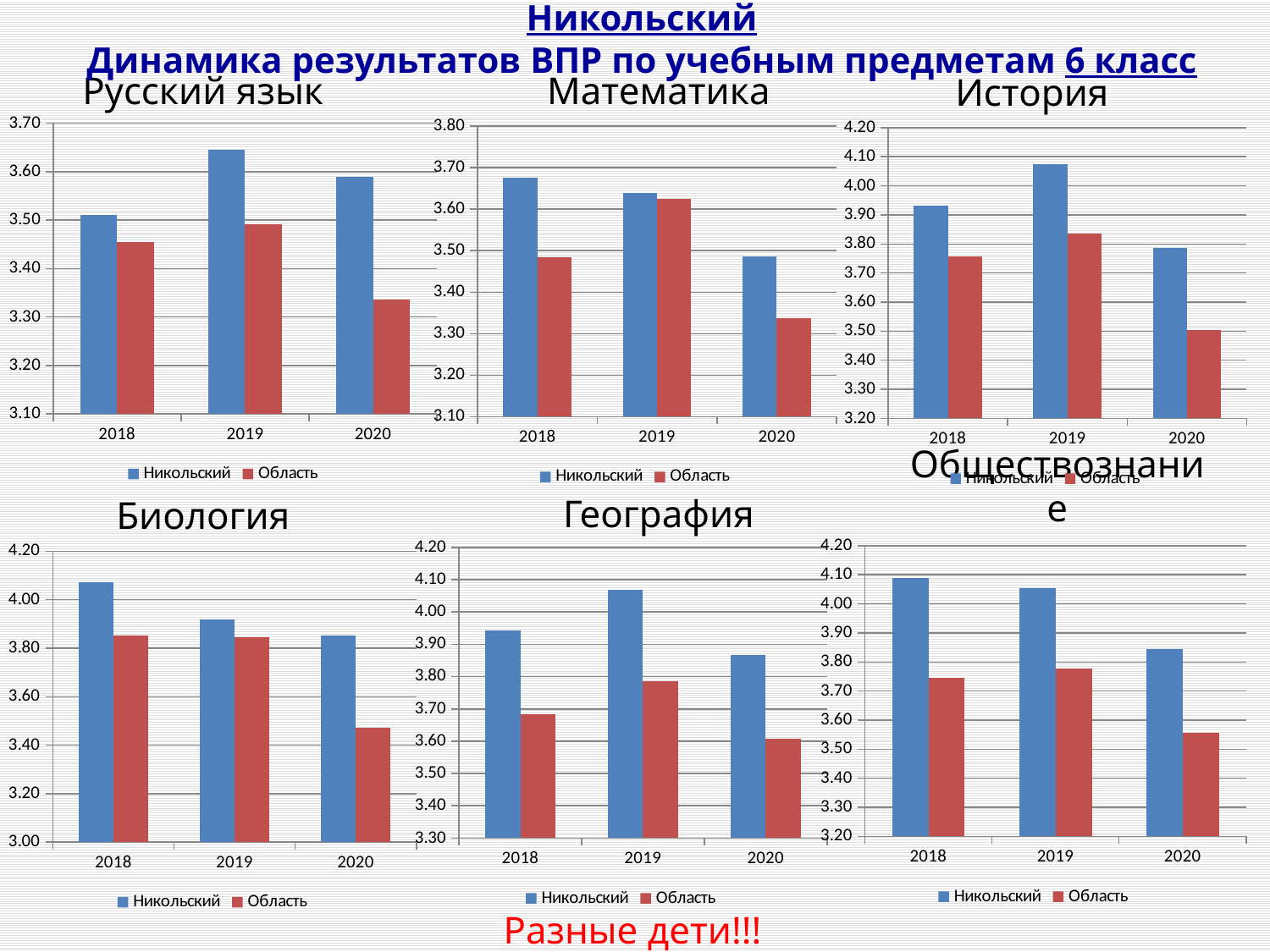
How many years are shown on the x axis of the История chart? 3 On the История chart, in which year is the Область bar lowest? 2020 What are the two legend entries on the География chart? Никольский and Область On the Биология chart, is the value for Никольский in 2018 greater or less than 4.00? greater On the География chart, which is larger in 2019: Никольский or Область? Никольский On the Математика chart, is the value for Область in 2020 greater or less than 3.40? less On the Математика chart, in which year is the Область bar highest? 2019 On the Русский язык chart, is the value for Область in 2020 greater or less than 3.40? less What kind of chart is the Математика chart? bar chart How many series does the legend of the Биология chart list? 2 On the Обществознание chart, do the Никольский values rise or fall from 2018 to 2020? fall On the Русский язык chart, in which year is the Никольский bar highest? 2019